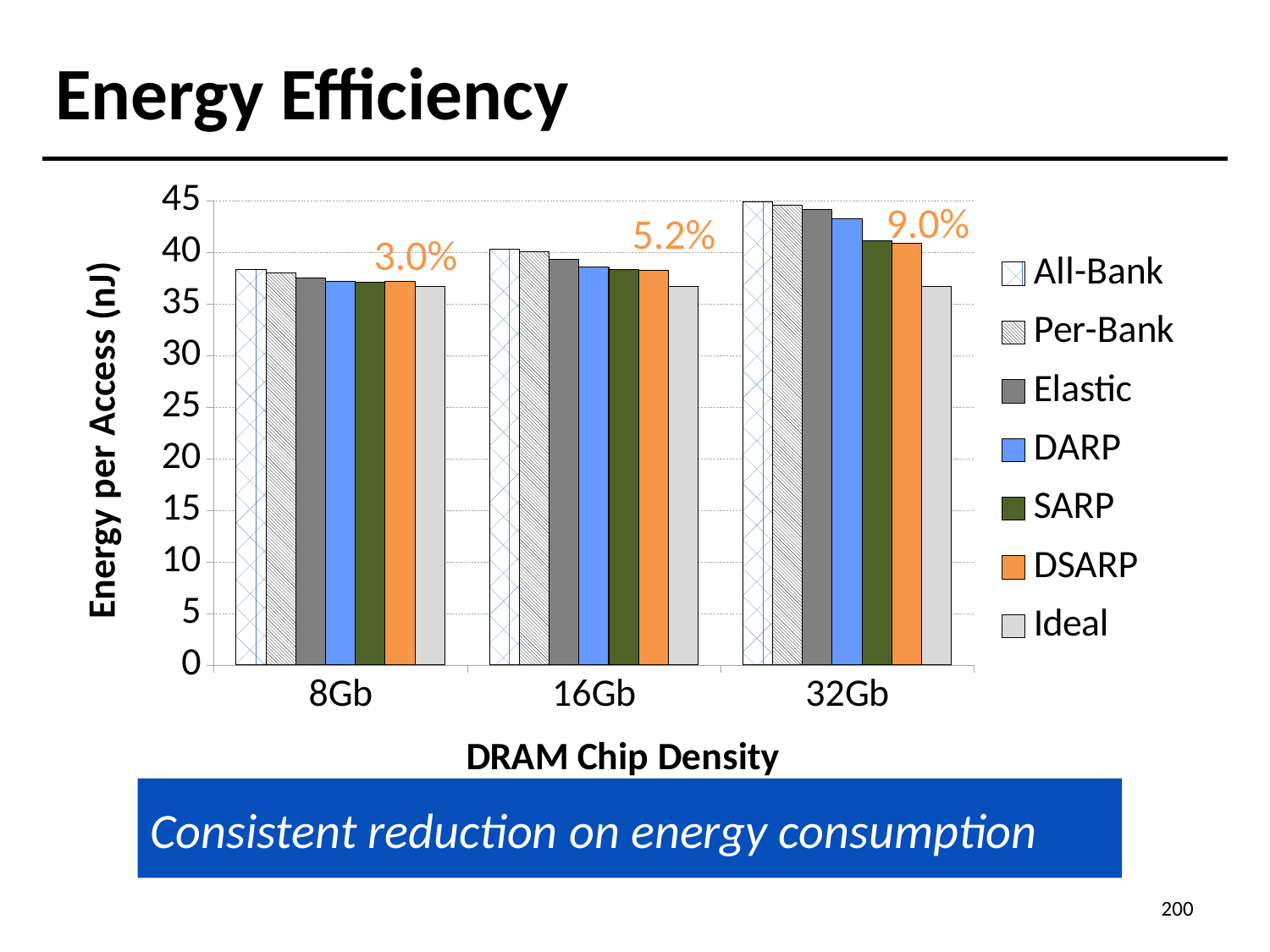
Do the All-Bank values rise or fall as DRAM chip density increases from 8Gb to 32Gb? rise At 32Gb, which is larger: the All-Bank value or the Ideal value? All-Bank How many DRAM chip density categories are shown on the x axis? 3 Is the value for DSARP at 16Gb greater or less than 40? less Is the value for SARP at 32Gb greater or less than 40? greater Is the value for All-Bank at 8Gb greater or less than 35? greater Which series has the lowest value at 32Gb? Ideal What kind of chart is shown on the slide? bar chart How many series does the legend list? 7 At which DRAM chip density is the All-Bank value highest? 32Gb What percentage label is printed above the 32Gb group of bars? 9.0%